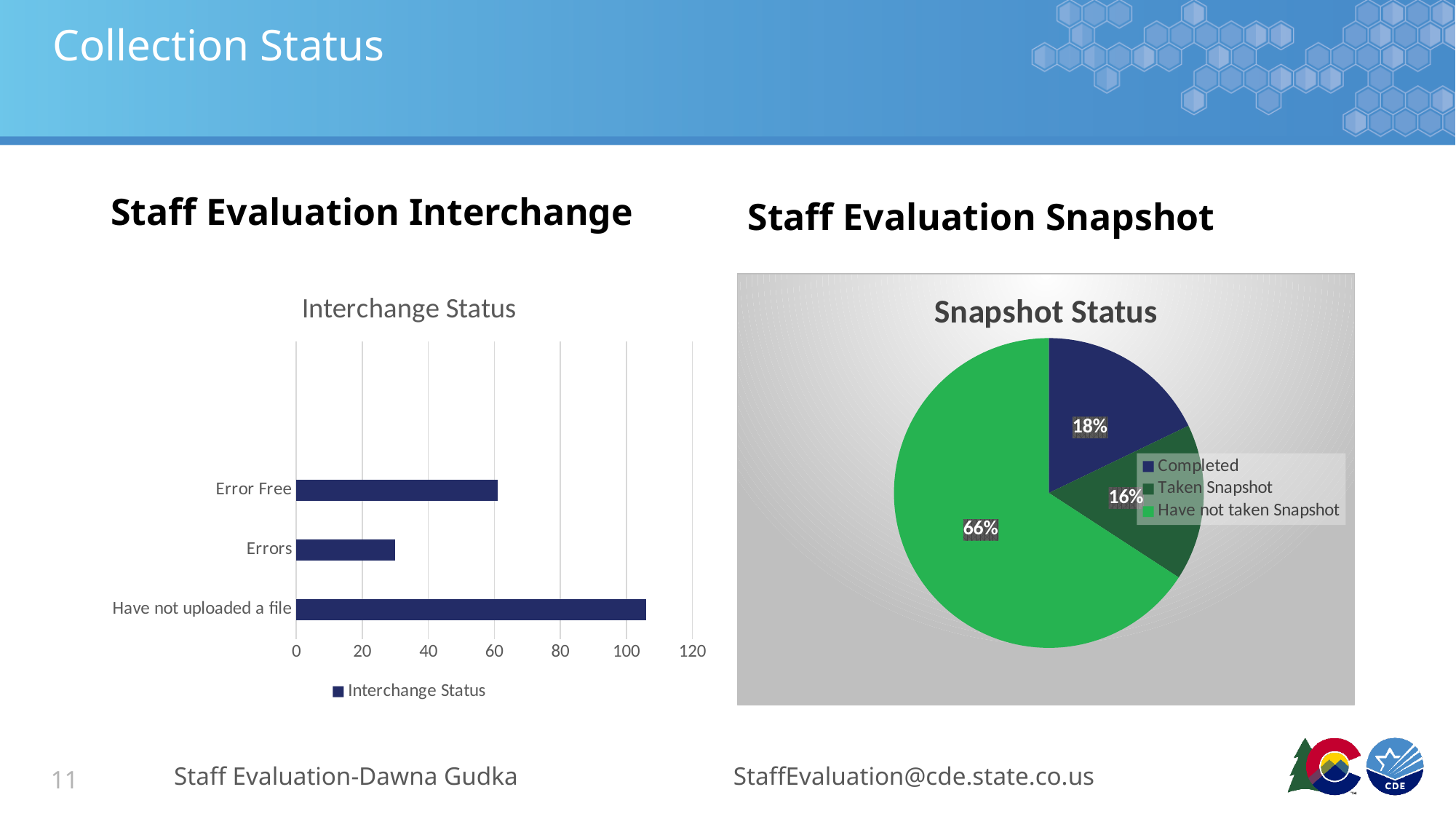
In the Snapshot Status chart, what share is labelled for Have not taken Snapshot? 66% In the Interchange Status chart, which category has the lowest value? Errors In the Interchange Status chart, is the value for Errors greater or less than 40? less In the Interchange Status chart, is the value for Have not uploaded a file greater or less than 100? greater How many categories are shown in the Interchange Status chart? 3 In the Snapshot Status chart, what share is labelled for Completed? 18% In the Interchange Status chart, is the value for Error Free greater or less than 40? greater In the Snapshot Status chart, which slice is the largest? Have not taken Snapshot What type of chart is the Interchange Status chart? bar chart In the Snapshot Status chart, what is the difference between the Have not taken Snapshot share and the Taken Snapshot share? 50% In the Interchange Status chart, which category has the highest value? Have not uploaded a file What type of chart is the Snapshot Status chart? pie chart